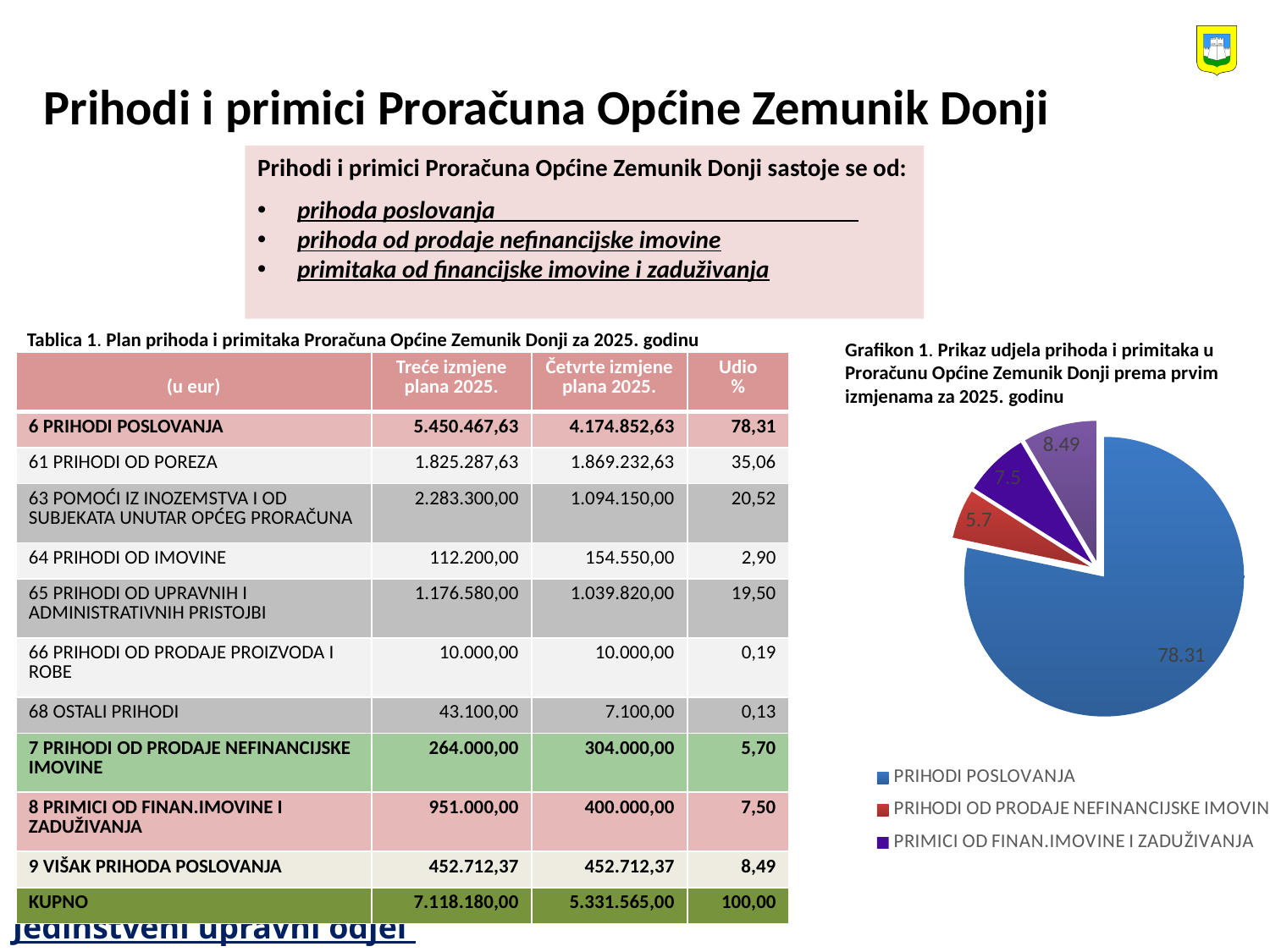
What is the difference between the PRIMICI OD FINAN.IMOVINE I ZADUŽIVANJA slice and the PRIHODI OD PRODAJE NEFINANCIJSKE IMOVINE slice in the pie chart? 1.8 Which category has the smallest slice in the pie chart? PRIHODI OD PRODAJE NEFINANCIJSKE IMOVINE How many entries does the legend of the pie chart list? 3 What value is shown for the PRIMICI OD FINAN.IMOVINE I ZADUŽIVANJA slice of the pie chart? 7.5 What value is shown for the PRIHODI OD PRODAJE NEFINANCIJSKE IMOVINE slice of the pie chart? 5.7 Which category has the largest slice in the pie chart? PRIHODI POSLOVANJA What is the difference between the PRIHODI POSLOVANJA slice and the PRIMICI OD FINAN.IMOVINE I ZADUŽIVANJA slice in the pie chart? 70.81 Which slice is larger in the pie chart: PRIMICI OD FINAN.IMOVINE I ZADUŽIVANJA or PRIHODI OD PRODAJE NEFINANCIJSKE IMOVINE? PRIMICI OD FINAN.IMOVINE I ZADUŽIVANJA How many slices does the pie chart have? 4 What value is shown for the PRIHODI POSLOVANJA slice of the pie chart? 78.31 What colour is the PRIHODI POSLOVANJA slice in the pie chart? blue What kind of chart is shown on the slide? pie chart